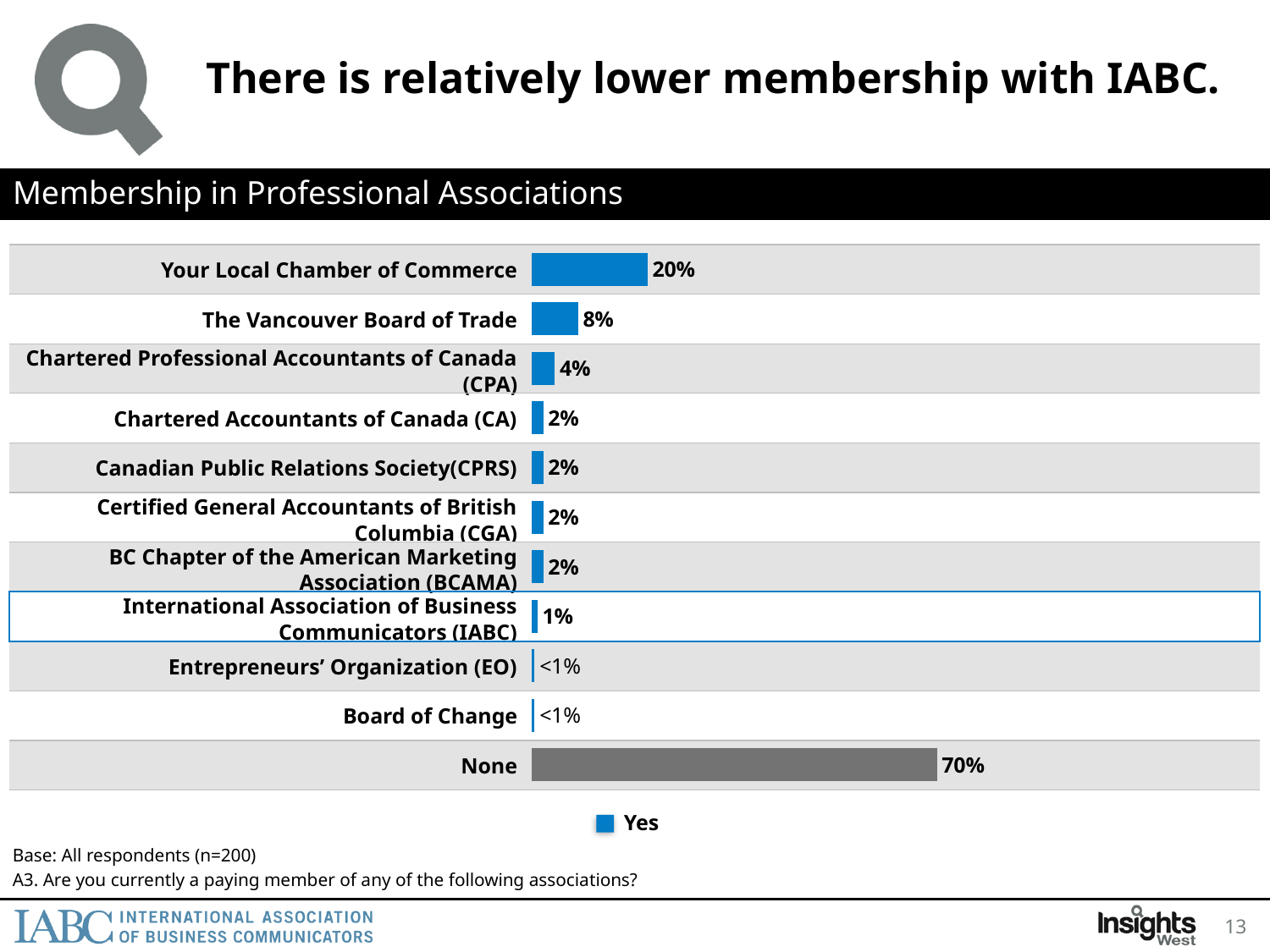
What value is shown for Chartered Professional Accountants of Canada (CPA)? 4% What is the title of the chart? Membership in Professional Associations What percentage is shown for the International Association of Business Communicators (IABC)? 1% How many categories are shown in the chart? 11 What type of chart is shown on the slide? Bar chart What is the value shown for None? 70% What is the difference between the values for Your Local Chamber of Commerce and The Vancouver Board of Trade? 12% Which category has the highest value in the chart? None Which is larger, the value for The Vancouver Board of Trade or the value for Chartered Professional Accountants of Canada (CPA)? The Vancouver Board of Trade What is the value shown for The Vancouver Board of Trade? 8% Excluding None, which association has the highest membership percentage? Your Local Chamber of Commerce What percentage of respondents are members of Your Local Chamber of Commerce? 20%